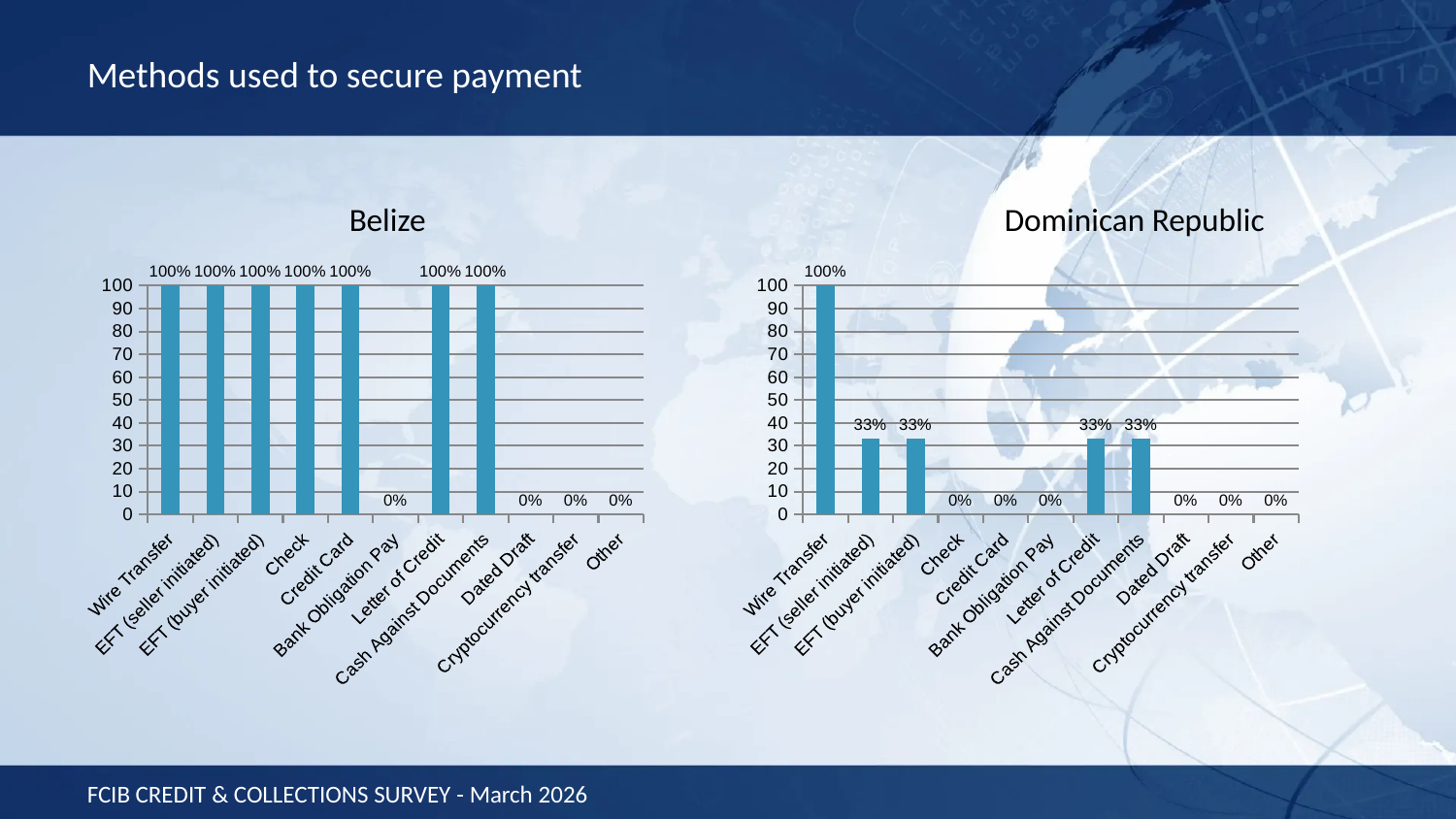
How many categories are shown on the x axis of the Belize chart? 11 In the Dominican Republic chart, what is the difference between Wire Transfer and Cash Against Documents? 67% What kind of chart is the Dominican Republic chart? Bar chart In the Dominican Republic chart, which category has the highest value? Wire Transfer What is the title of the chart on the right side of the slide? Dominican Republic In the Dominican Republic chart, what is the value for Check? 0% In the Dominican Republic chart, what is the value for Wire Transfer? 100% In the Belize chart, what is the value for Letter of Credit? 100% In the Belize chart, what is the value for Bank Obligation Pay? 0% In the Belize chart, which is larger, Check or Dated Draft? Check In the Dominican Republic chart, which is larger, Letter of Credit or Credit Card? Letter of Credit In the Dominican Republic chart, what is the value for EFT (seller initiated)? 33%